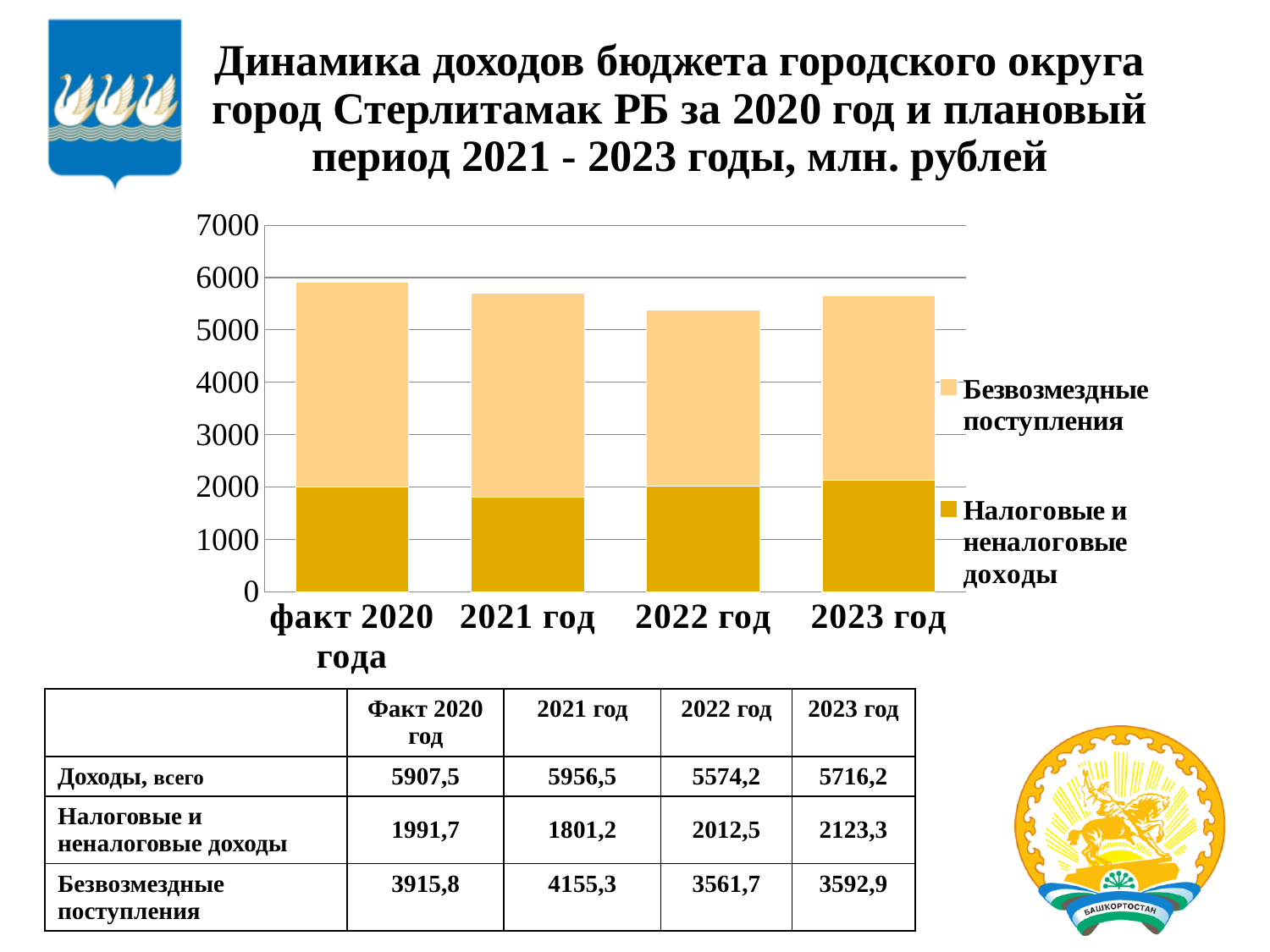
How many categories are shown on the x axis of the chart? 4 Which category has the lowest value for Налоговые и неналоговые доходы? 2021 год Which category has the shortest stacked bar in the chart? 2022 год Is the value for Налоговые и неналоговые доходы in 2021 год greater or less than 2000? less Which category has the tallest stacked bar in the chart? факт 2020 года What is the unit of measurement stated in the chart title? млн. рублей How many series does the chart legend list? 2 Which is larger: the Налоговые и неналоговые доходы value for 2023 год or for 2021 год? 2023 год Which series is shown in the lighter (pale orange) colour in the chart? Безвозмездные поступления Is the total stacked bar for факт 2020 года greater or less than 5000? greater Is the total stacked bar for 2022 год greater or less than 6000? less What kind of chart is shown on the slide? stacked bar chart